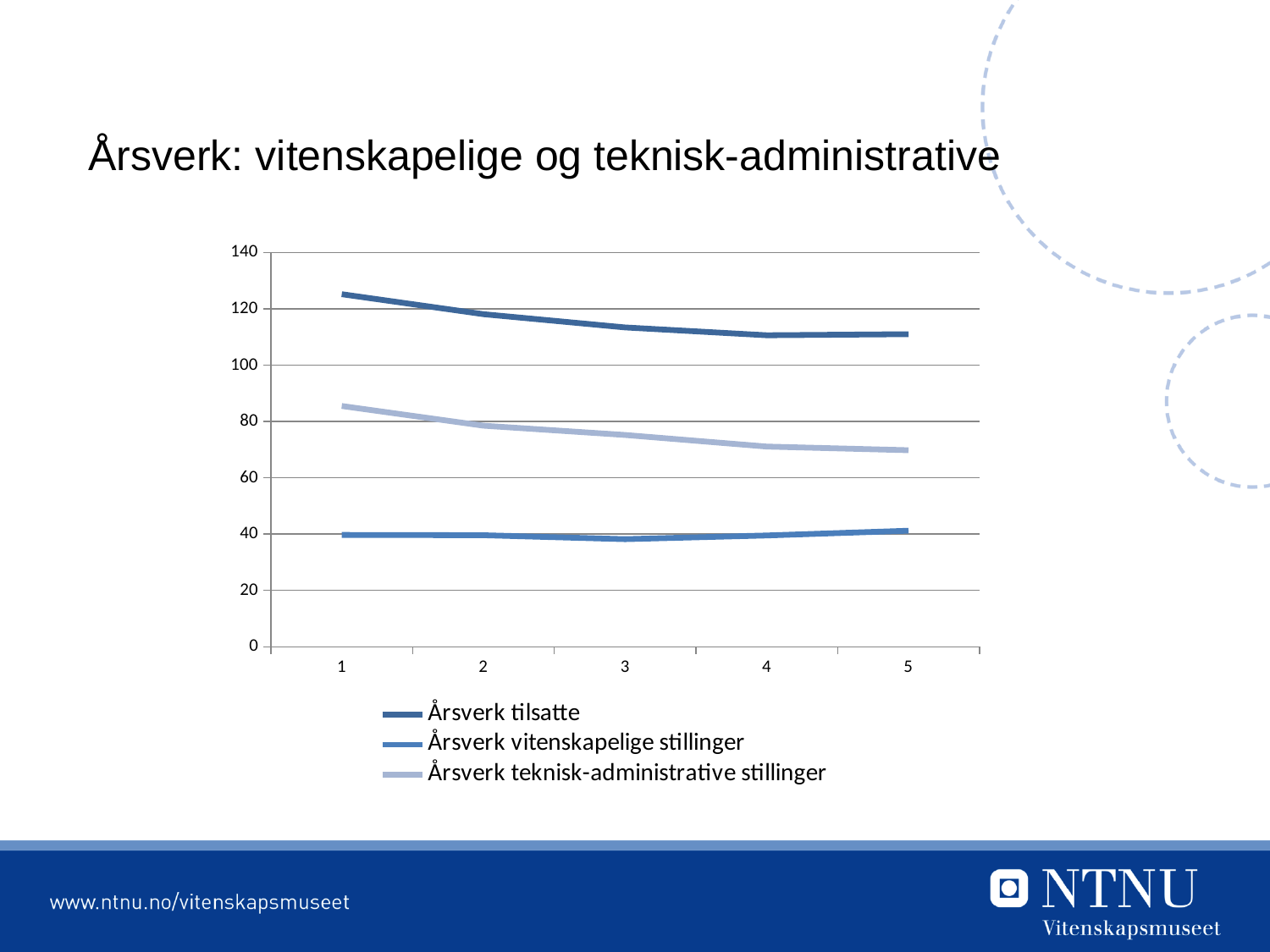
Is the value for Årsverk vitenskapelige stillinger at point 3 greater or less than 60? less How many points are there along the x axis? 5 What kind of chart is shown on the slide? line chart Does the line for Årsverk tilsatte rise or fall from point 1 to point 4? fall How many series does the legend list? 3 Is the value for Årsverk tilsatte at point 1 greater or less than 120? greater Is the value for Årsverk tilsatte at point 5 greater or less than 100? greater At point 1, which is higher: Årsverk tilsatte or Årsverk teknisk-administrative stillinger? Årsverk tilsatte Does the line for Årsverk teknisk-administrative stillinger rise or fall from point 1 to point 5? fall What is the title of the slide? Årsverk: vitenskapelige og teknisk-administrative Which series has the lowest values across the chart? Årsverk vitenskapelige stillinger